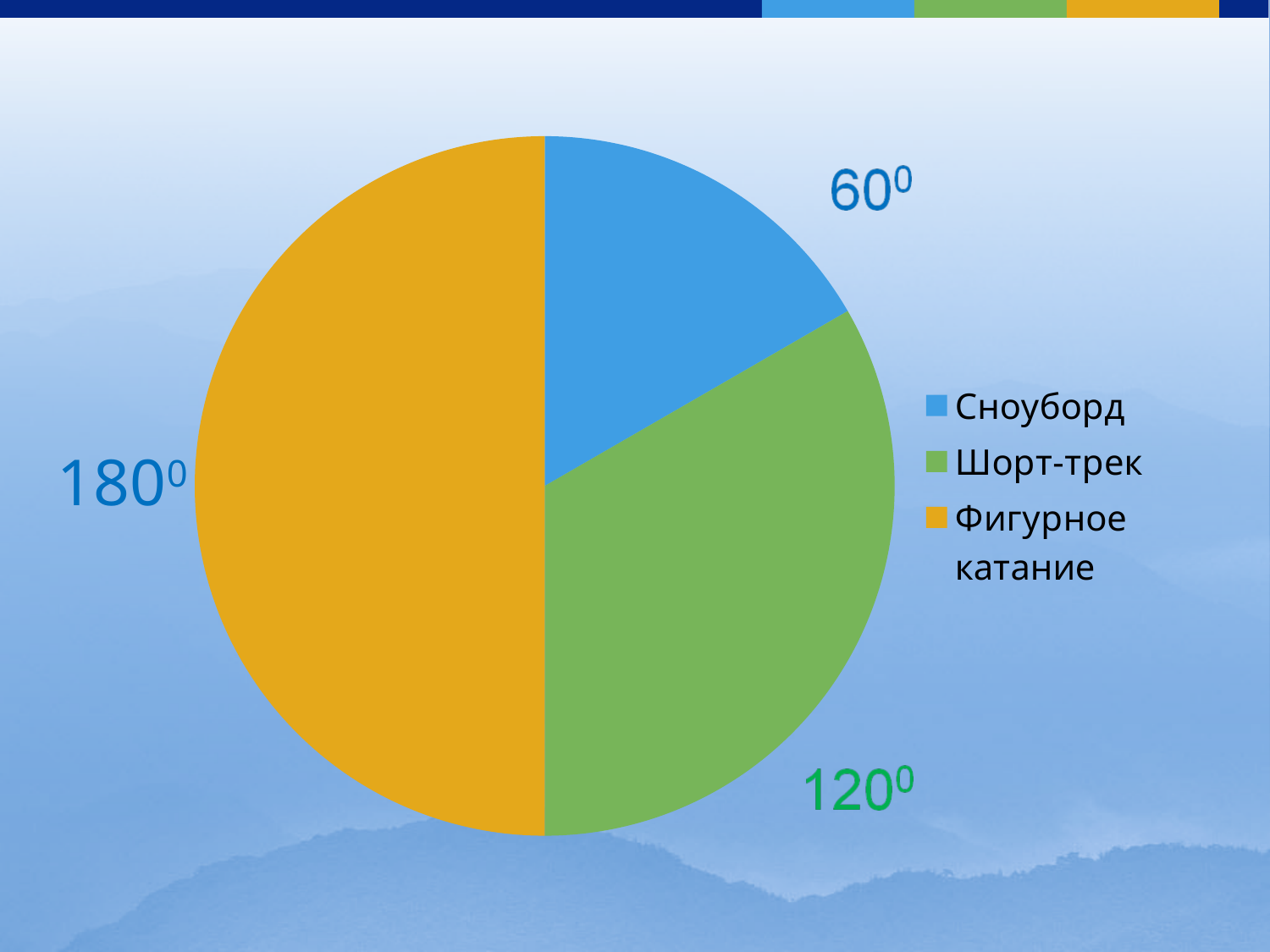
What kind of chart is shown on the slide? pie chart What is the value shown for Шорт-трек? 120⁰ What colour is the slice for Шорт-трек? green What is the value shown for Фигурное катание? 180⁰ Which category has the largest slice? Фигурное катание What is the difference between the values for Фигурное катание and Сноуборд? 120⁰ What is the value shown for Сноуборд? 60⁰ How many slices does the pie chart have? 3 Which is larger, the slice for Шорт-трек or the slice for Сноуборд? Шорт-трек What share of the pie does Фигурное катание take? 50% How many entries does the legend list? 3 Which category has the smallest slice? Сноуборд